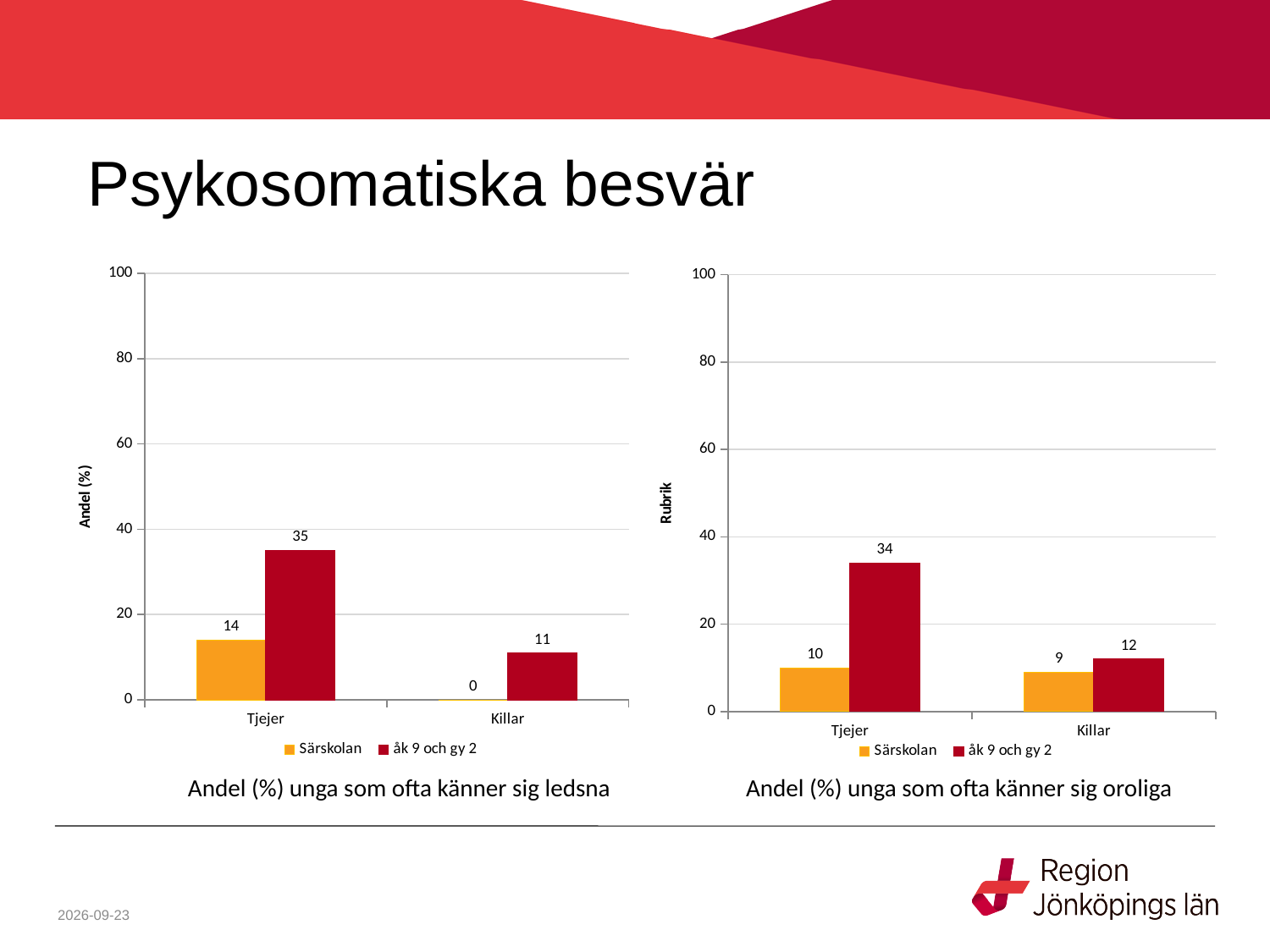
In the right chart (Andel (%) unga som ofta känner sig oroliga), which is larger for Killar: Särskolan or åk 9 och gy 2? åk 9 och gy 2 What kind of chart is the left chart (Andel (%) unga som ofta känner sig ledsna)? Bar chart In the left chart (Andel (%) unga som ofta känner sig ledsna), what is the value for Tjejer in the Särskolan series? 14 In the left chart (Andel (%) unga som ofta känner sig ledsna), is the value for Tjejer in the åk 9 och gy 2 series greater or less than 20? greater How many series does the legend of the right chart (Andel (%) unga som ofta känner sig oroliga) list? 2 In the left chart (Andel (%) unga som ofta känner sig ledsna), what is the value for Killar in the åk 9 och gy 2 series? 11 In the left chart (Andel (%) unga som ofta känner sig ledsna), what is the difference between the åk 9 och gy 2 and Särskolan values for Tjejer? 21 In the left chart (Andel (%) unga som ofta känner sig ledsna), which category has the highest value in the åk 9 och gy 2 series? Tjejer What is the y-axis label of the left chart (Andel (%) unga som ofta känner sig ledsna)? Andel (%) In the right chart (Andel (%) unga som ofta känner sig oroliga), what is the value for Tjejer in the åk 9 och gy 2 series? 34 In the right chart (Andel (%) unga som ofta känner sig oroliga), what is the difference between the Tjejer and Killar values in the åk 9 och gy 2 series? 22 In the right chart (Andel (%) unga som ofta känner sig oroliga), what is the value for Killar in the Särskolan series? 9